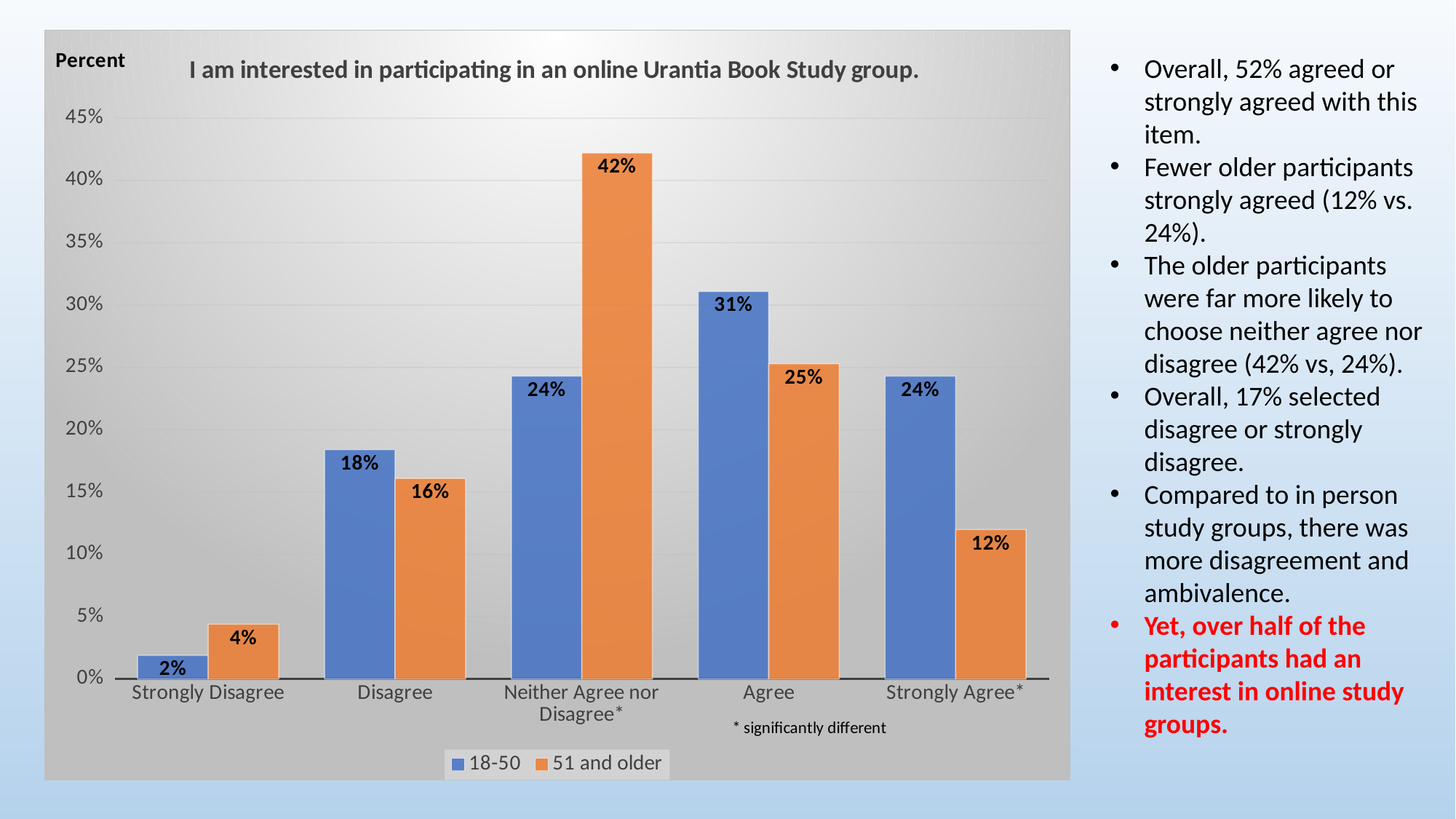
What kind of chart is shown on the slide? Bar chart Which category has the lowest value for the 18-50 series? Strongly Disagree Which category has the highest value for the 51 and older series? Neither Agree nor Disagree How many categories are shown on the x axis? 5 What is the title of the chart? I am interested in participating in an online Urantia Book Study group. In the Disagree category, which series has the larger value, 18-50 or 51 and older? 18-50 What is the value for the 18-50 series in the Agree category? 31% Which colour represents the 51 and older series? Orange How many series does the legend list? 2 What is the value for the 51 and older series in the Neither Agree nor Disagree category? 42% What is the difference between the 18-50 and 51 and older values in the Strongly Agree category? 12% What is the value for the 51 and older series in the Strongly Agree category? 12%